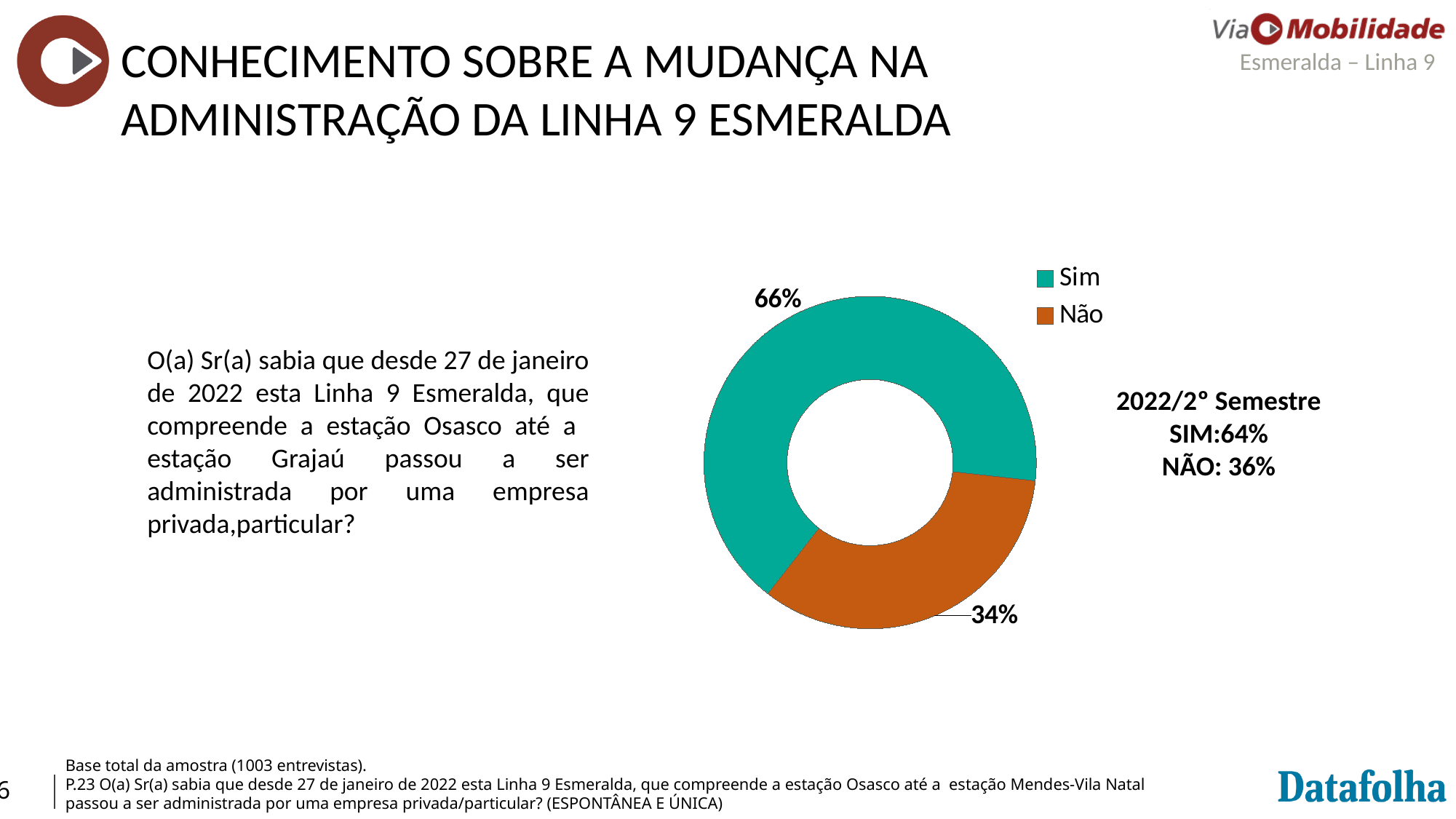
Which category has the smallest share of the pie chart? Não What colour is the "Não" slice in the pie chart? Orange (brown) Which category has the largest share of the pie chart? Sim Which slice is larger, "Sim" or "Não"? Sim How many slices does the pie chart have? 2 What colour is the "Sim" slice in the pie chart? Teal (green) What is the difference in percentage points between the "Sim" and "Não" slices? 32 What share of the pie does the "Não" slice represent? 34% What kind of chart is shown on the slide? Pie chart (donut) What percentage of the pie chart is labelled "Sim"? 66% What percentage of the pie chart is labelled "Não"? 34% How many entries does the chart legend list? 2